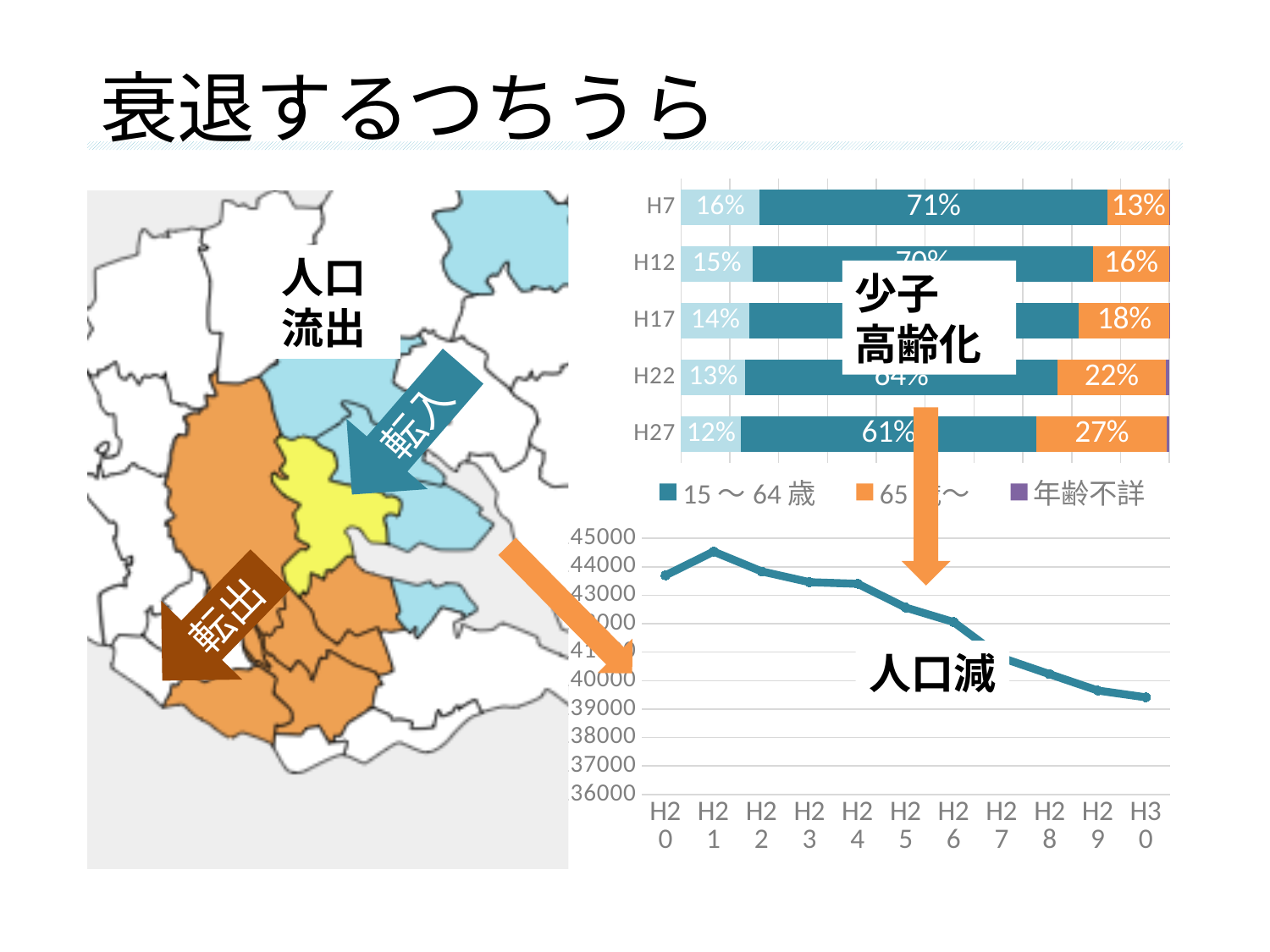
In the stacked bar chart at the top right, what is the 65歳～ share for H27? 27% In the line chart at the bottom right, do the values generally rise or fall from H20 to H30? fall In the stacked bar chart at the top right, by how many percentage points does the 65歳～ share for H27 exceed that for H7? 14% In the stacked bar chart at the top right, what is the 15～64歳 share for H27? 61% In the line chart at the bottom right, is the value for H30 greater or less than 40000? less In the stacked bar chart at the top right, what is the 65歳～ share for H7? 13% In the stacked bar chart at the top right, what is the 15～64歳 share for H7? 71% How many years (bars) are shown in the stacked bar chart at the top right? 5 How many data points are plotted in the line chart at the bottom right? 11 In the stacked bar chart at the top right, which has the larger 65歳～ share, H17 or H22? H22 What kind of chart is the chart at the bottom right of the slide? line chart In the stacked bar chart at the top right, which year has the highest 65歳～ share? H27